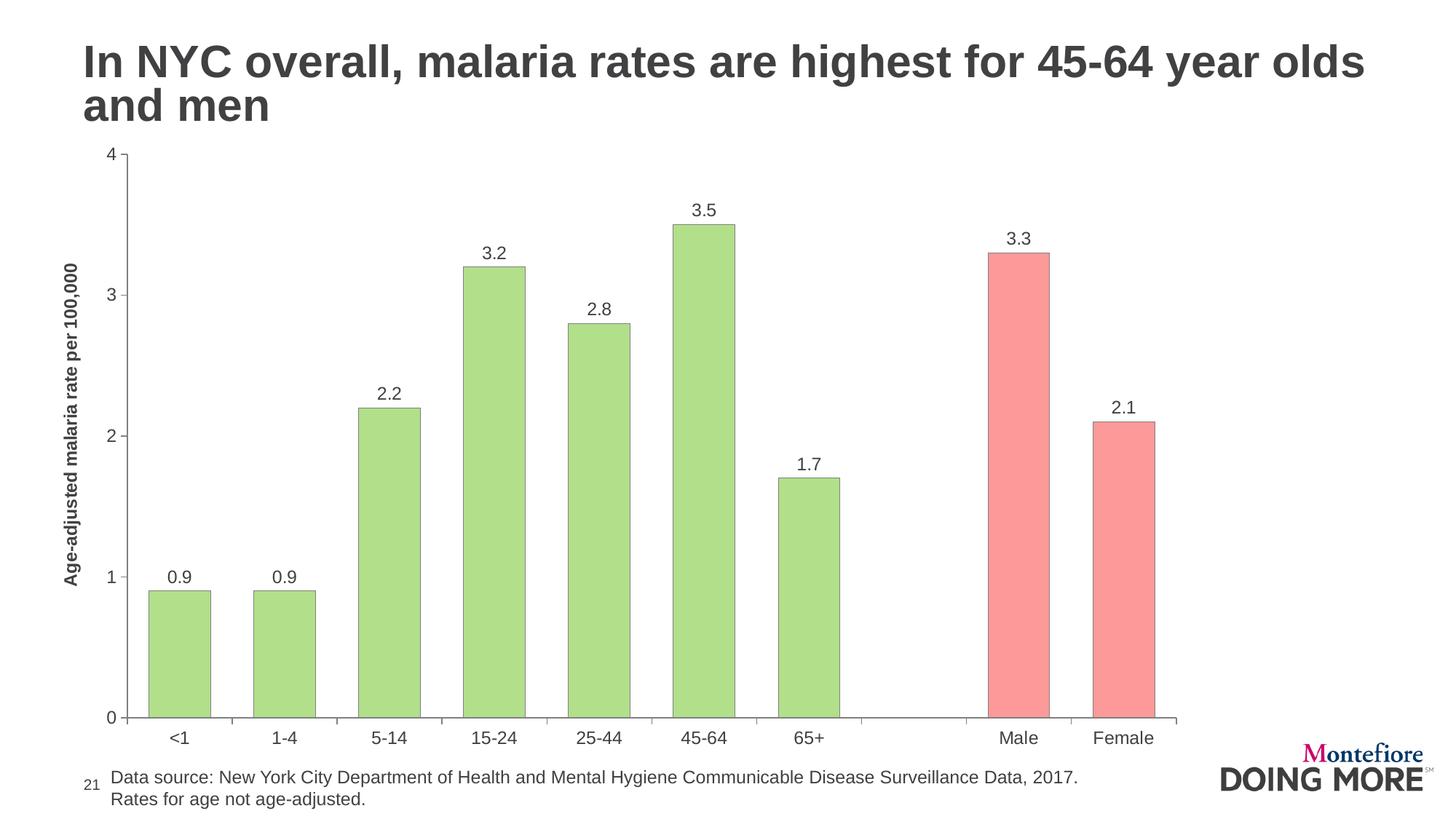
What is the malaria rate per 100,000 for the 65+ age group? 1.7 What is the difference between the male and female malaria rates? 1.2 Which age group has the highest malaria rate? 45-64 What kind of chart is shown on the slide? Bar chart What is the age-adjusted malaria rate per 100,000 for the 45-64 age group? 3.5 What is the difference between the malaria rates for the 45-64 and 65+ age groups? 1.8 Is the malaria rate for the 5-14 age group greater or less than 2? greater Which category has the lowest malaria rate among all bars shown? <1 and 1-4 (both 0.9) Which has a higher malaria rate, the 15-24 age group or the 25-44 age group? 15-24 What is the malaria rate per 100,000 for males? 3.3 What is the label of the vertical axis? Age-adjusted malaria rate per 100,000 How many bars are plotted on the chart? 9